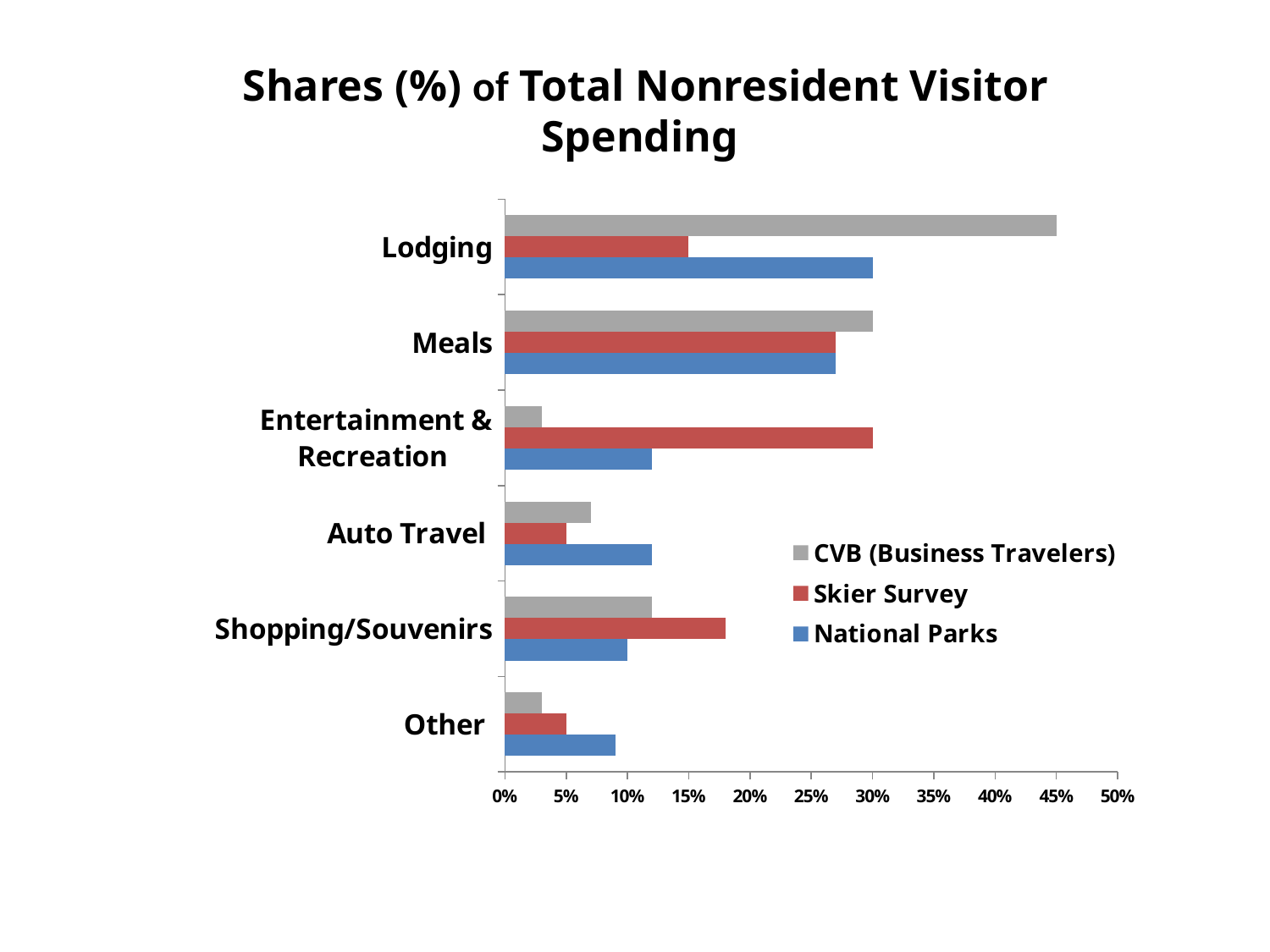
Which category has the highest share for CVB (Business Travelers)? Lodging How many series does the legend list? 3 What is the difference between the CVB (Business Travelers) share and the National Parks share for Lodging? 15% Is the National Parks share for Meals greater or less than 25%? greater Is the CVB (Business Travelers) share for Auto Travel greater or less than 10%? less Is the Skier Survey share for Shopping/Souvenirs greater or less than 15%? greater For Entertainment & Recreation, which is larger: the Skier Survey share or the National Parks share? Skier Survey What is the CVB (Business Travelers) share for Lodging? 45% What colour represents the Skier Survey series in the legend? red What is the National Parks share for Lodging? 30% What kind of chart is shown on the slide? bar chart How many spending categories are shown on the chart? 6